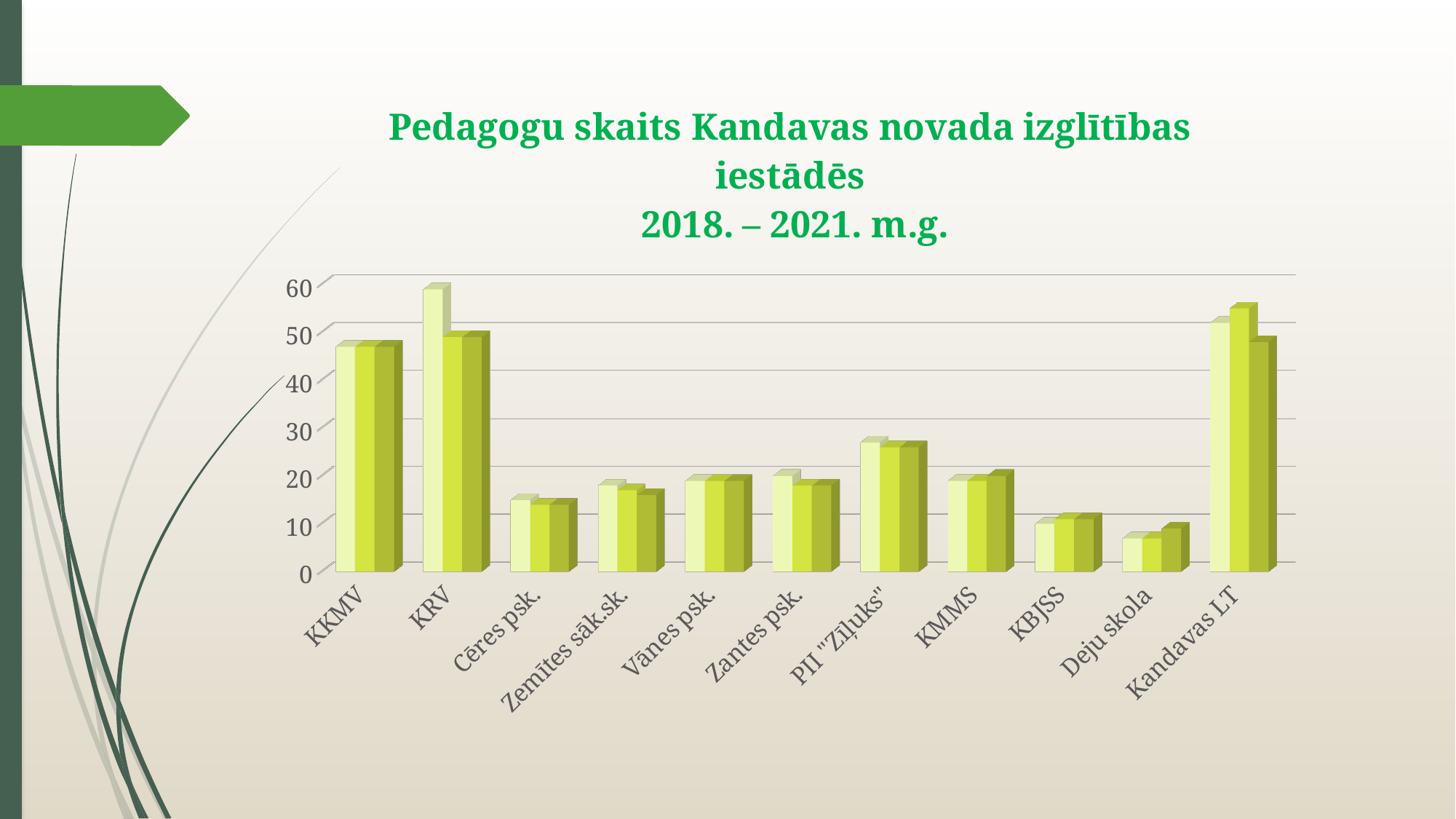
Are the bars for Cēres psk. greater or less than 20? less What is the title of the chart? Pedagogu skaits Kandavas novada izglītības iestādēs 2018. – 2021. m.g. Are the bars for PII "Zīļuks" greater or less than 20? greater Are the bars for Deju skola greater or less than 10? less How many categories (institutions) are shown on the x axis? 11 Which category has the lowest bars in the chart? Deju skola Which category has the tallest bar in the chart? KRV What kind of chart is shown on the slide? bar chart Which has higher values, KKMV or Cēres psk.? KKMV Which has higher values, Kandavas LT or KMMS? Kandavas LT